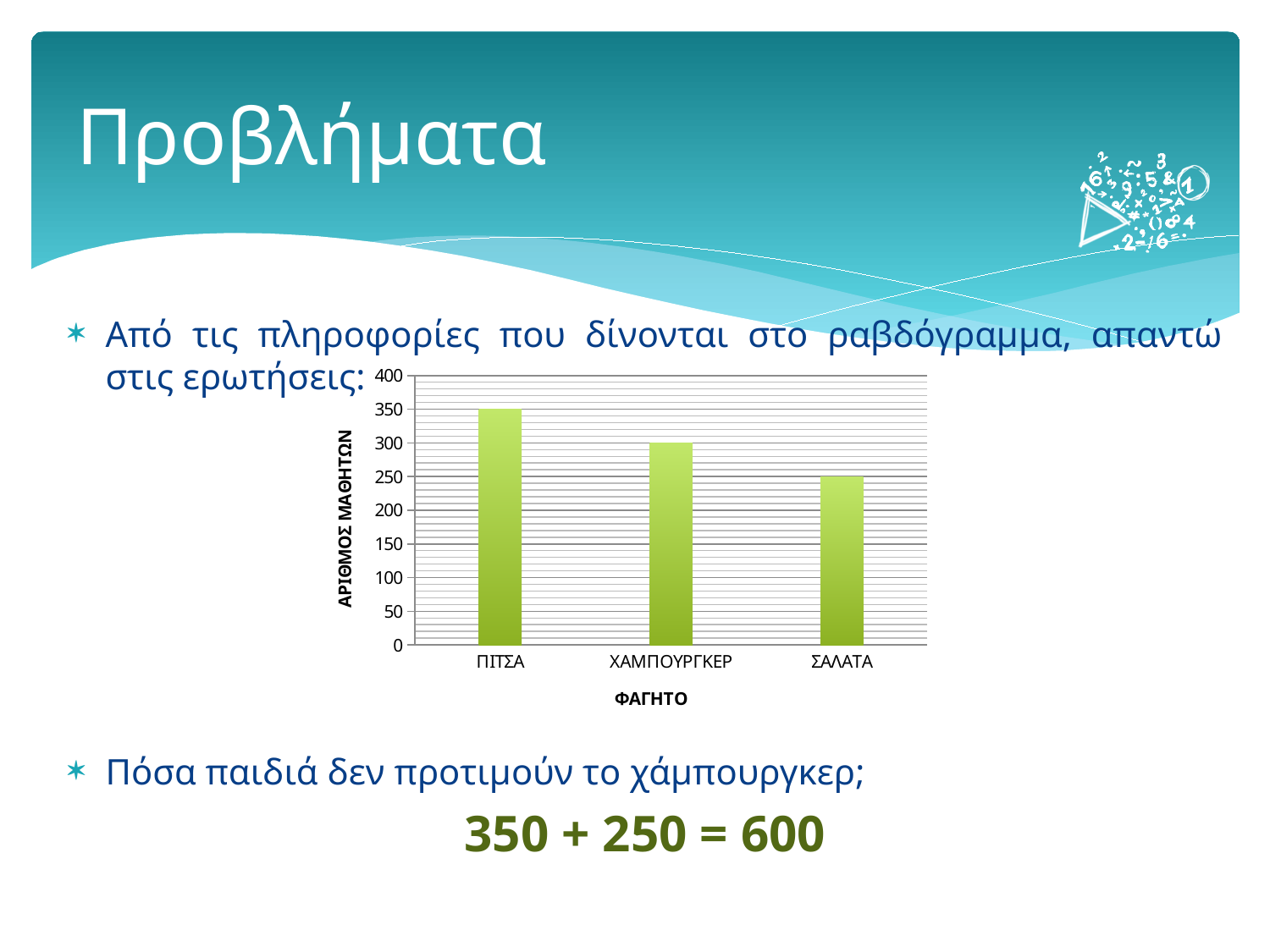
Which has more students, ΧΑΜΠΟΥΡΓΚΕΡ or ΣΑΛΑΤΑ? ΧΑΜΠΟΥΡΓΚΕΡ What is the label of the horizontal axis of the chart? ΦΑΓΗΤΟ What is the number of students for ΣΑΛΑΤΑ? 250 Which food has the lowest number of students? ΣΑΛΑΤΑ Which food has the highest number of students? ΠΙΤΣΑ What is the label of the vertical axis of the chart? ΑΡΙΘΜΟΣ ΜΑΘΗΤΩΝ What is the number of students for ΠΙΤΣΑ? 350 What is the number of students for ΧΑΜΠΟΥΡΓΚΕΡ? 300 What type of chart is shown on the slide? bar chart What is the difference between the number of students for ΠΙΤΣΑ and for ΣΑΛΑΤΑ? 100 How many food categories are shown on the x axis of the chart? 3 Do the values rise or fall moving from left to right along the x axis? fall